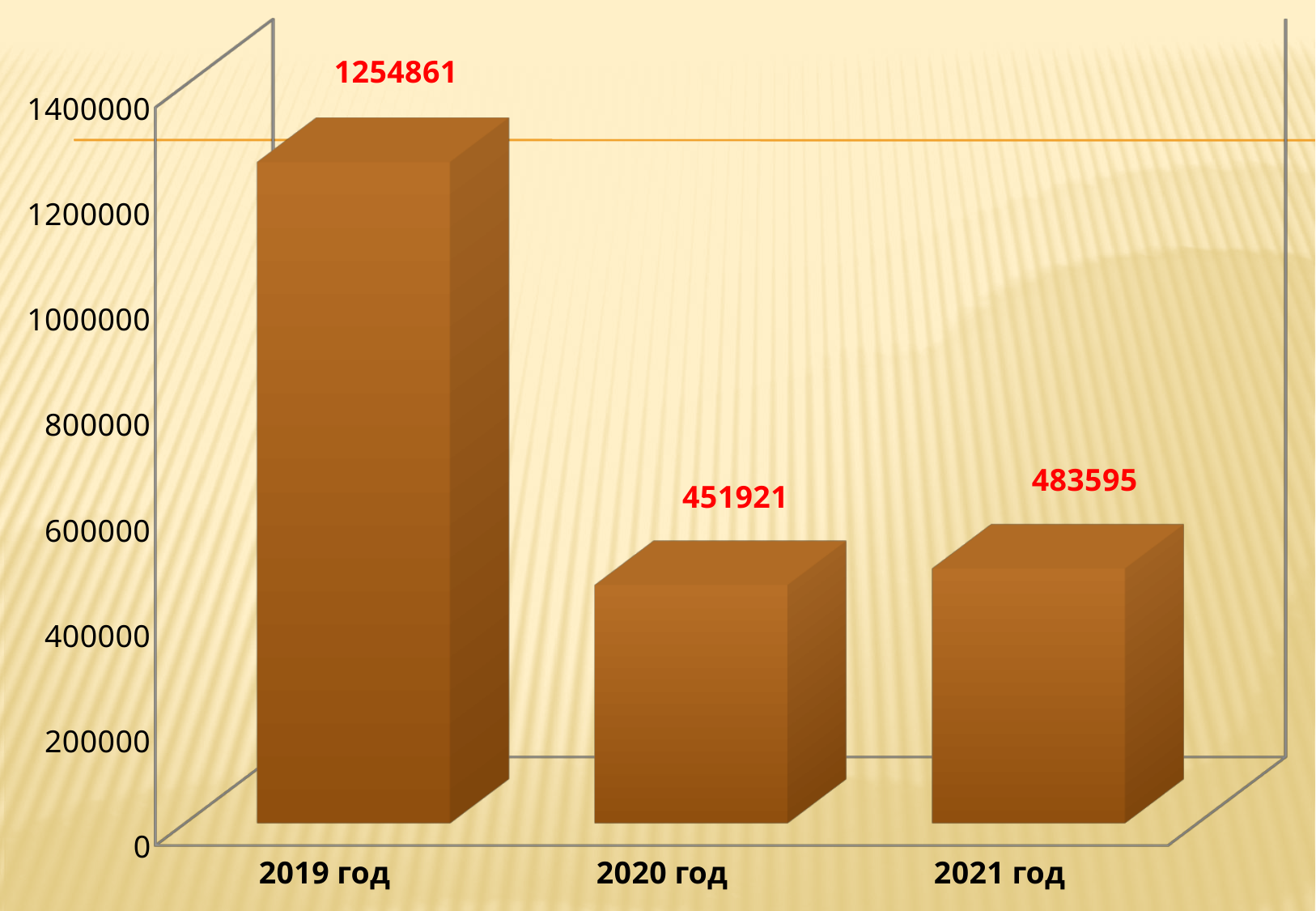
What is the difference between the values for 2021 год and 2020 год? 31674 What is the difference between the values for 2019 год and 2020 год? 802940 Is the value for 2020 год greater or less than 600000? less What is the value for 2019 год? 1254861 Which year has the highest value? 2019 год What is the total of the values for all three years? 2190377 How many years are shown on the chart? 3 What kind of chart is shown on the slide? bar chart Which year has the lowest value? 2020 год What is the value for 2021 год? 483595 Which is larger, the value for 2019 год or the value for 2021 год? 2019 год What is the value for 2020 год? 451921